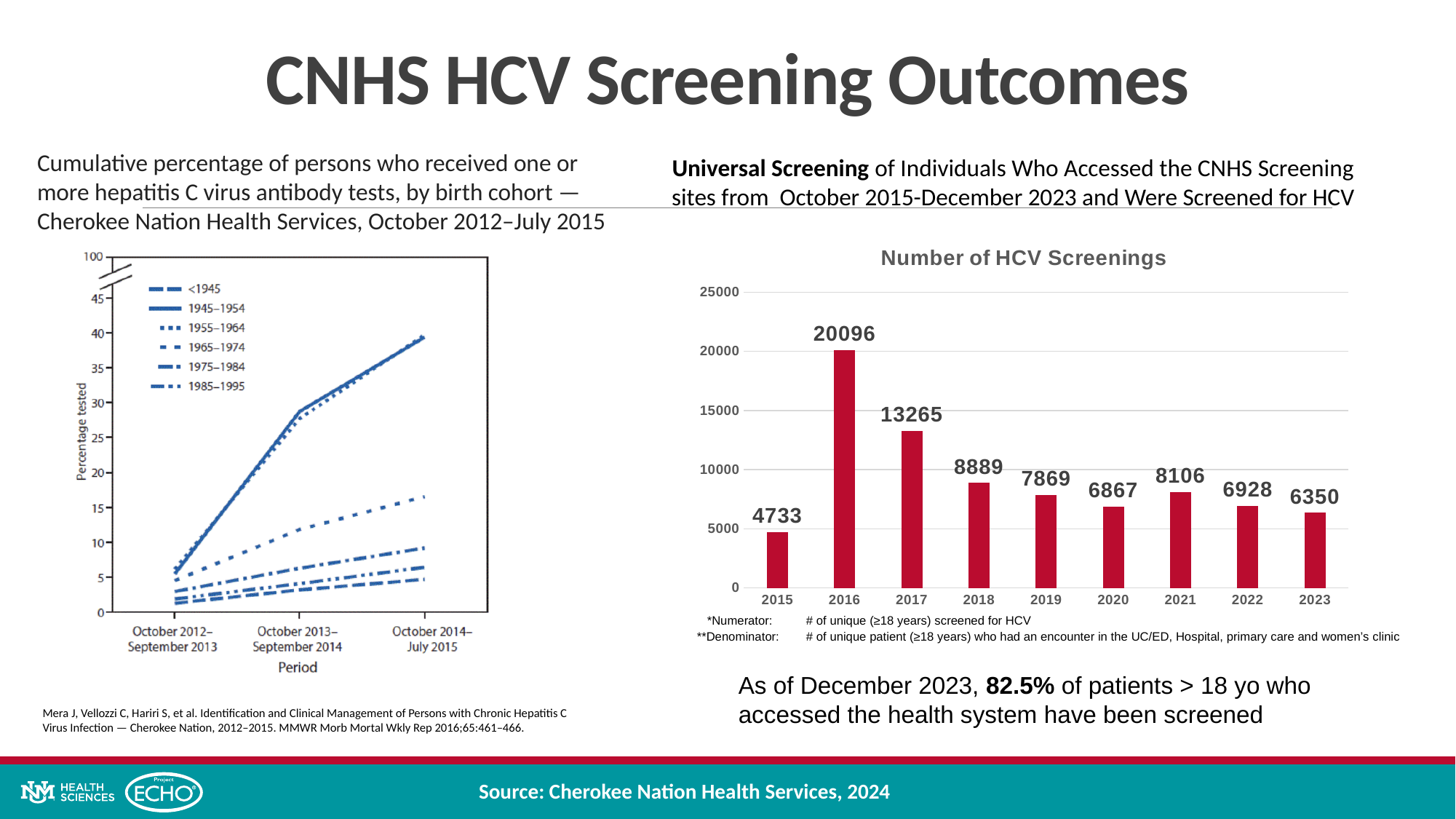
In the Number of HCV Screenings chart, what is the value for 2023? 6350 In the left line chart of cumulative percentage tested by birth cohort, how many birth cohorts does the legend list? 6 In the Number of HCV Screenings chart, which year has more screenings, 2021 or 2022? 2021 In the Number of HCV Screenings chart, which year has the lowest number of screenings? 2015 In the Number of HCV Screenings chart, which year has the highest number of screenings? 2016 In the Number of HCV Screenings chart, how many years are shown on the x axis? 9 In the left line chart, is the percentage tested for the 1945–1954 cohort in October 2014–July 2015 greater or less than 35? greater In the left line chart, does the percentage tested for the 1955–1964 cohort rise or fall across the periods? Rise In the Number of HCV Screenings chart, do the values rise or fall from 2016 to 2020? Fall In the Number of HCV Screenings chart, what is the difference between the 2016 and 2017 values? 6831 In the Number of HCV Screenings chart, how many HCV screenings were there in 2016? 20096 What kind of chart is the Number of HCV Screenings chart? Bar chart